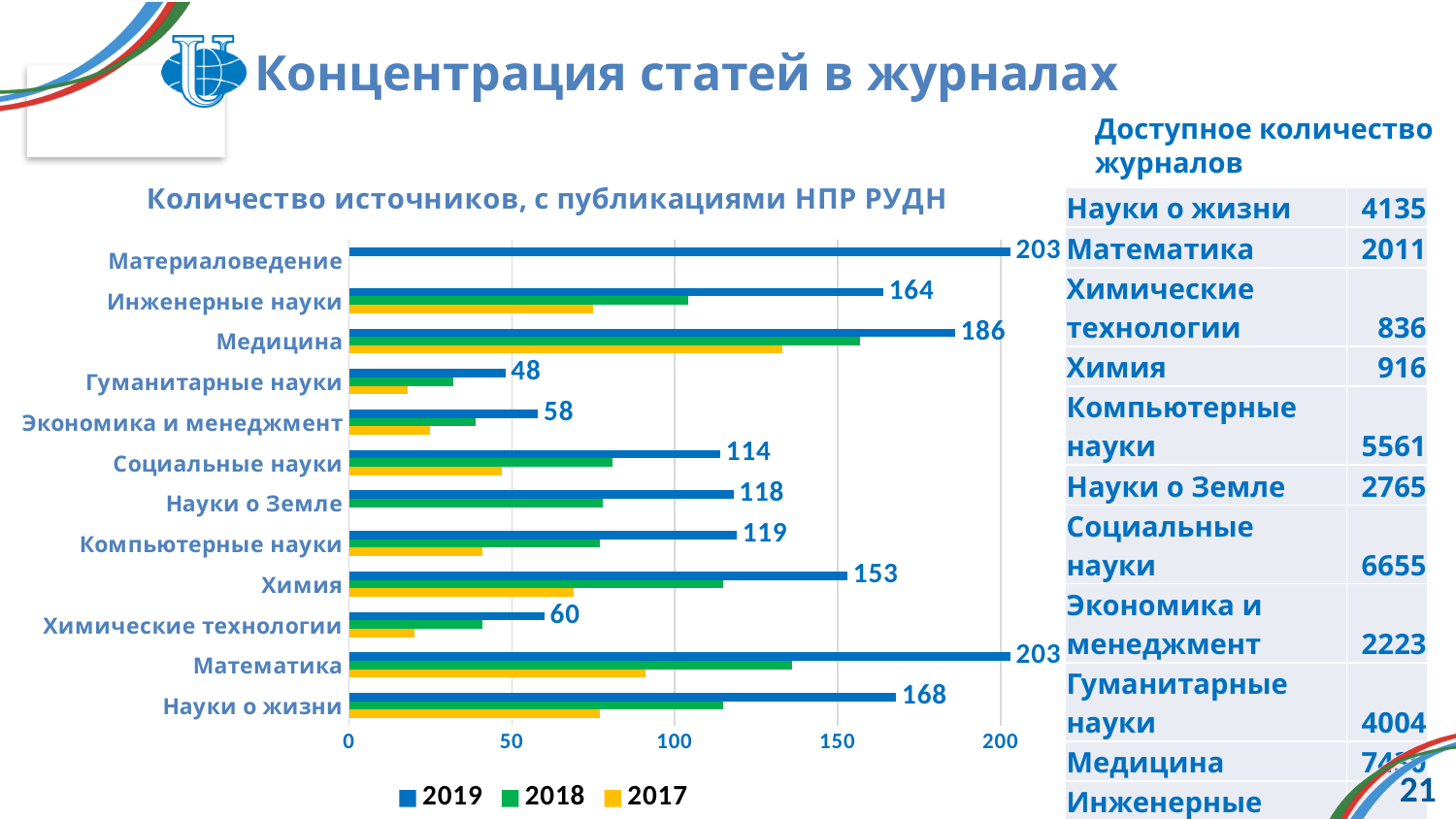
How many series does the chart legend list? 3 What is the title of the chart? Количество источников, с публикациями НПР РУДН What type of chart is shown on the slide? bar chart What is the difference between the 2019 values for Математика and Химические технологии? 143 How many categories are shown on the chart? 12 Which category has the lowest 2019 value? Гуманитарные науки What is the 2019 value for Медицина? 186 Is the 2018 value for Гуманитарные науки greater or less than 50? less Which has the larger 2019 value, Инженерные науки or Социальные науки? Инженерные науки Is the 2018 value for Медицина greater or less than 150? greater What is the 2019 value for Науки о жизни? 168 What is the 2019 value for Химия? 153